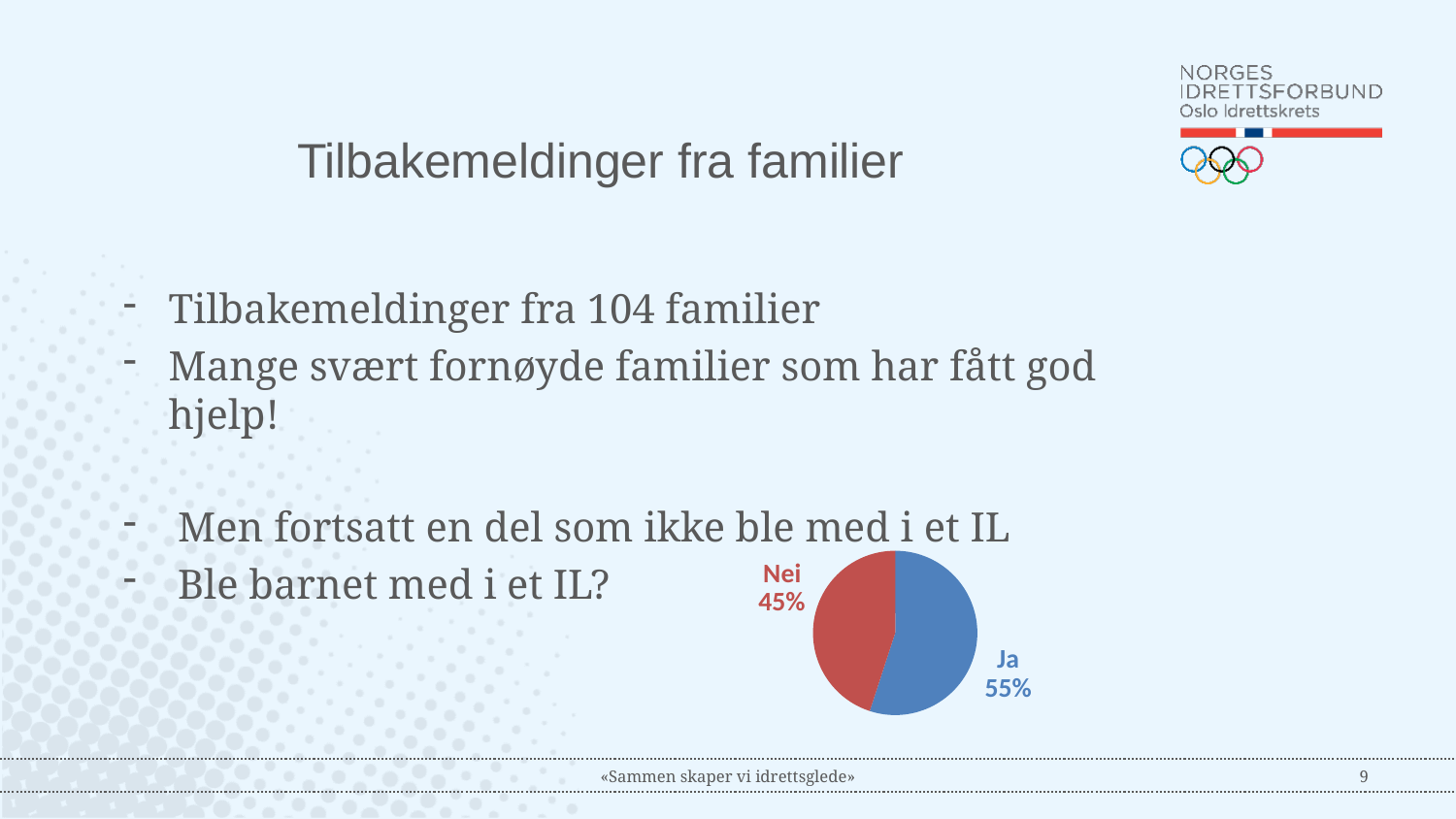
What kind of chart is shown on the slide? pie chart Is the share for "Ja" greater or less than 50%? greater Which is larger in the pie chart, "Ja" or "Nei"? Ja How many slices does the pie chart have? 2 What share of the pie chart is labelled "Nei"? 45% Which slice of the pie chart is the largest? Ja What is the difference in percentage points between the "Ja" and "Nei" slices? 10 Which slice of the pie chart is the smallest? Nei What colour is the "Ja" slice of the pie chart? blue What share of the pie chart is labelled "Ja"? 55% What colour is the "Nei" slice of the pie chart? red